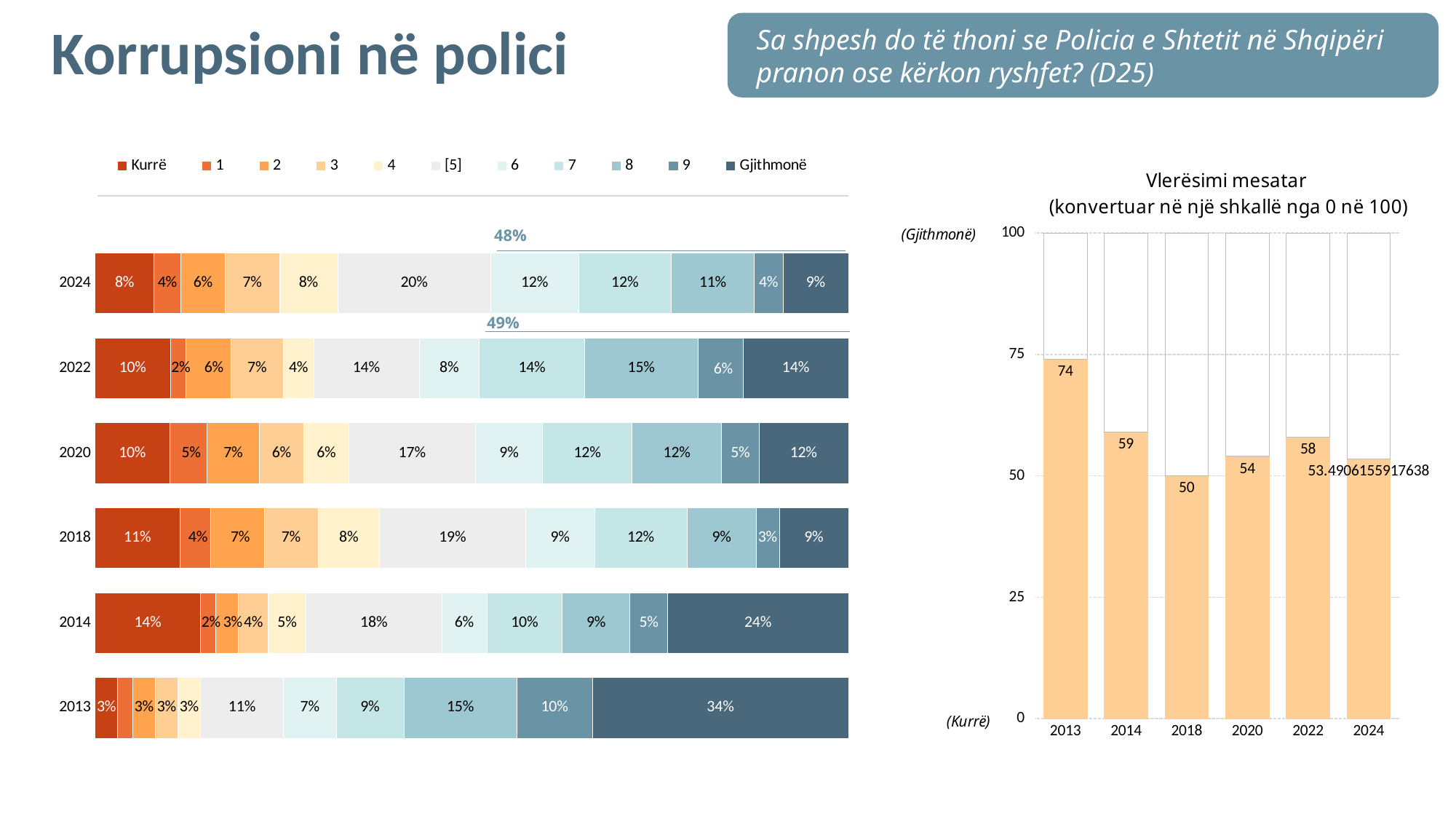
In the stacked bar chart on the left, what percentage of respondents answered "Gjithmonë" in 2013? 34% How many years are shown in the stacked bar chart on the left? 6 In the stacked bar chart on the left, what percentage answered "Kurrë" in 2024? 8% In the stacked bar chart on the left, is the "Kurrë" share larger in 2014 or in 2013? 2014 How many series does the legend of the stacked bar chart on the left list? 11 In the stacked bar chart on the left, what is the difference in percentage points between the "Gjithmonë" share in 2013 and in 2024? 25 percentage points In the chart titled "Vlerësimi mesatar", is the value for 2024 greater or less than 50? greater What kind of chart is the chart titled "Vlerësimi mesatar"? Bar chart In the stacked bar chart on the left, which year has the highest share for "Gjithmonë"? 2013 In the chart titled "Vlerësimi mesatar", what is the difference between the values for 2013 and 2014? 15 In the chart titled "Vlerësimi mesatar", which year has the lowest value? 2018 In the chart titled "Vlerësimi mesatar", what is the value for 2013? 74